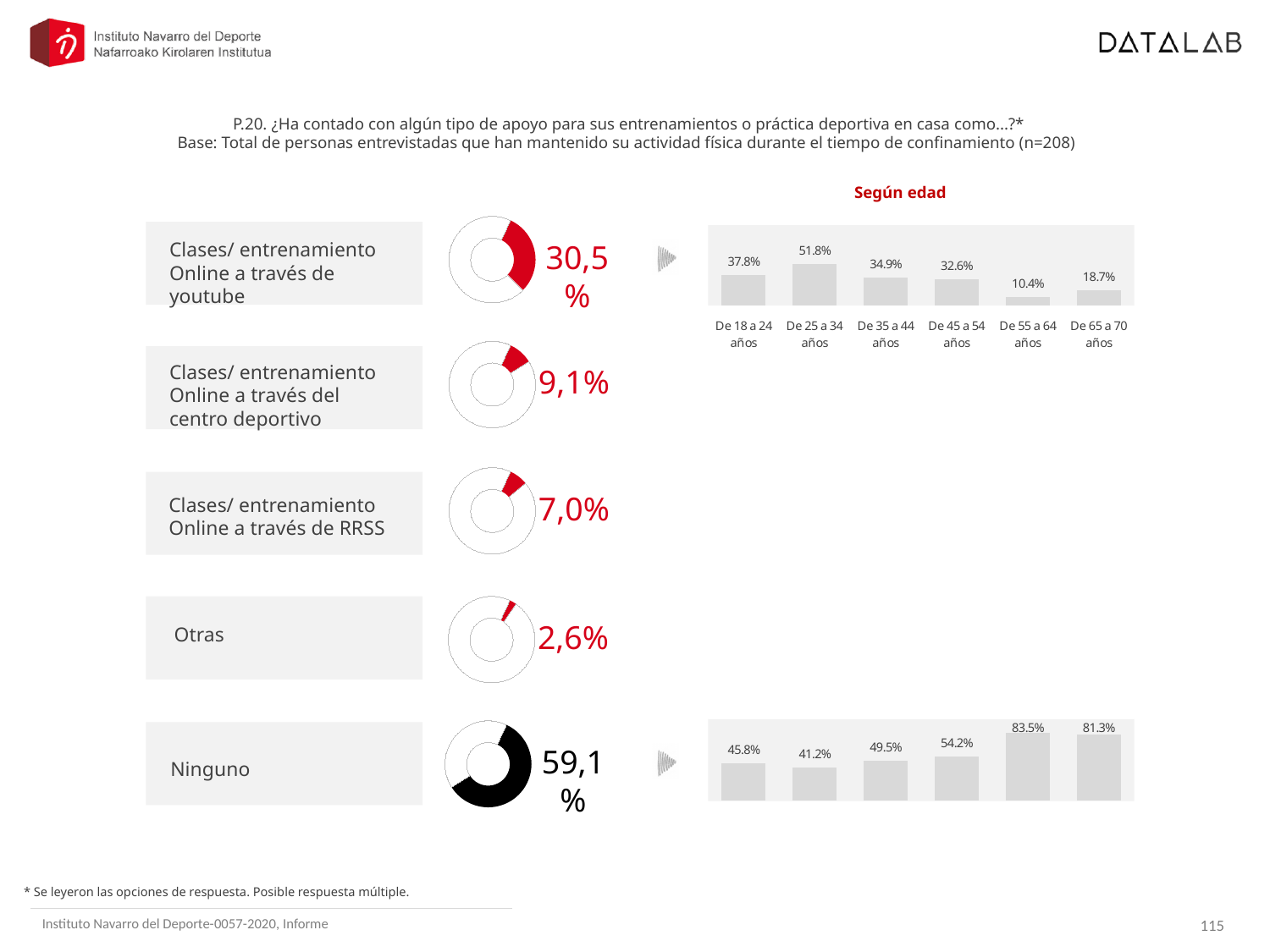
What percentage is shown in the donut chart for 'Otras'? 2,6% What kind of chart is used to show the values by age group on the right side of the slide? Bar chart What percentage is shown in the donut chart for 'Ninguno'? 59,1% In the top bar chart by age (next to the youtube donut), which age group has the lowest value? De 55 a 64 años Among the five donut charts on the slide, which category has the lowest percentage? Otras Among the five donut charts on the slide, which category has the highest percentage? Ninguno In the bottom bar chart by age (next to the Ninguno donut), what is the value for 'De 45 a 54 años'? 54.2% How many age groups are shown in the top bar chart by age? 6 What percentage is shown in the donut chart for 'Clases/ entrenamiento Online a través de youtube'? 30,5% In the bottom bar chart by age (next to the Ninguno donut), which age group has the highest value? De 55 a 64 años In the bottom bar chart by age (next to the Ninguno donut), what is the difference between the values for 'De 55 a 64 años' and 'De 18 a 24 años'? 37.7% In the top bar chart by age (next to the youtube donut), what is the value for 'De 25 a 34 años'? 51.8%